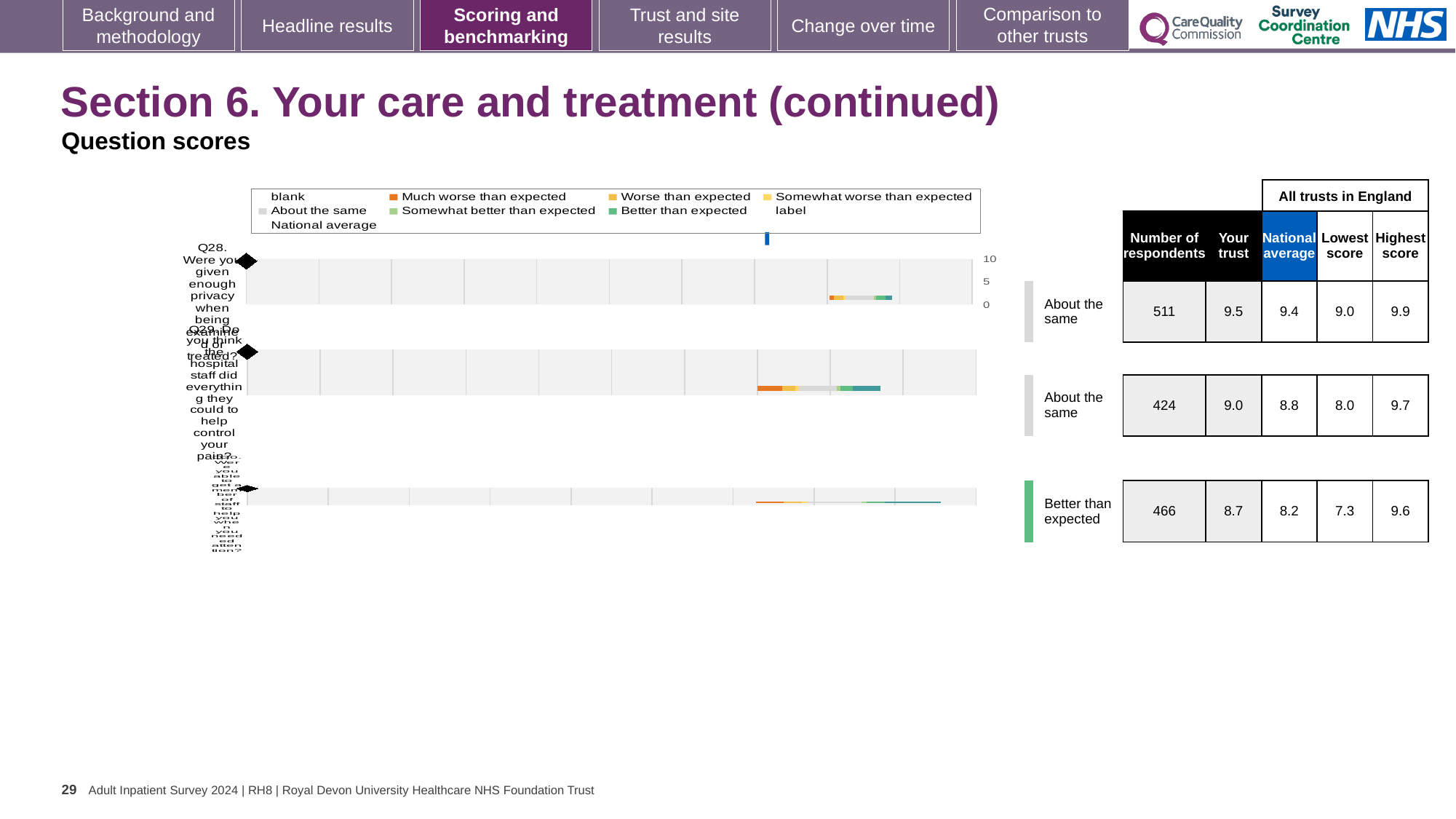
What kind of chart is used to show the question scores on this slide? bar chart Which question has the lowest 'Lowest score' across all trusts in England? Q30 Which question has the highest 'Your trust' score? Q28 How many respondents answered Q30 (able to get a member of staff to help when needed)? 466 Which is larger for Q28: the trust score or the national average? the trust score (9.5) What is the 'Your trust' score for Q28 (privacy when being examined or treated)? 9.5 How many questions (Q28, Q29, Q30) are plotted on the slide? 3 What benchmark category is given for Q30? Better than expected Is the trust score for Q29 greater or less than 5 on the score axis? greater What is the highest value shown on the score axis of the charts? 10 What is the difference between the trust score and the national average for Q30? 0.5 What is the national average score for Q29 (hospital staff helping control pain)? 8.8